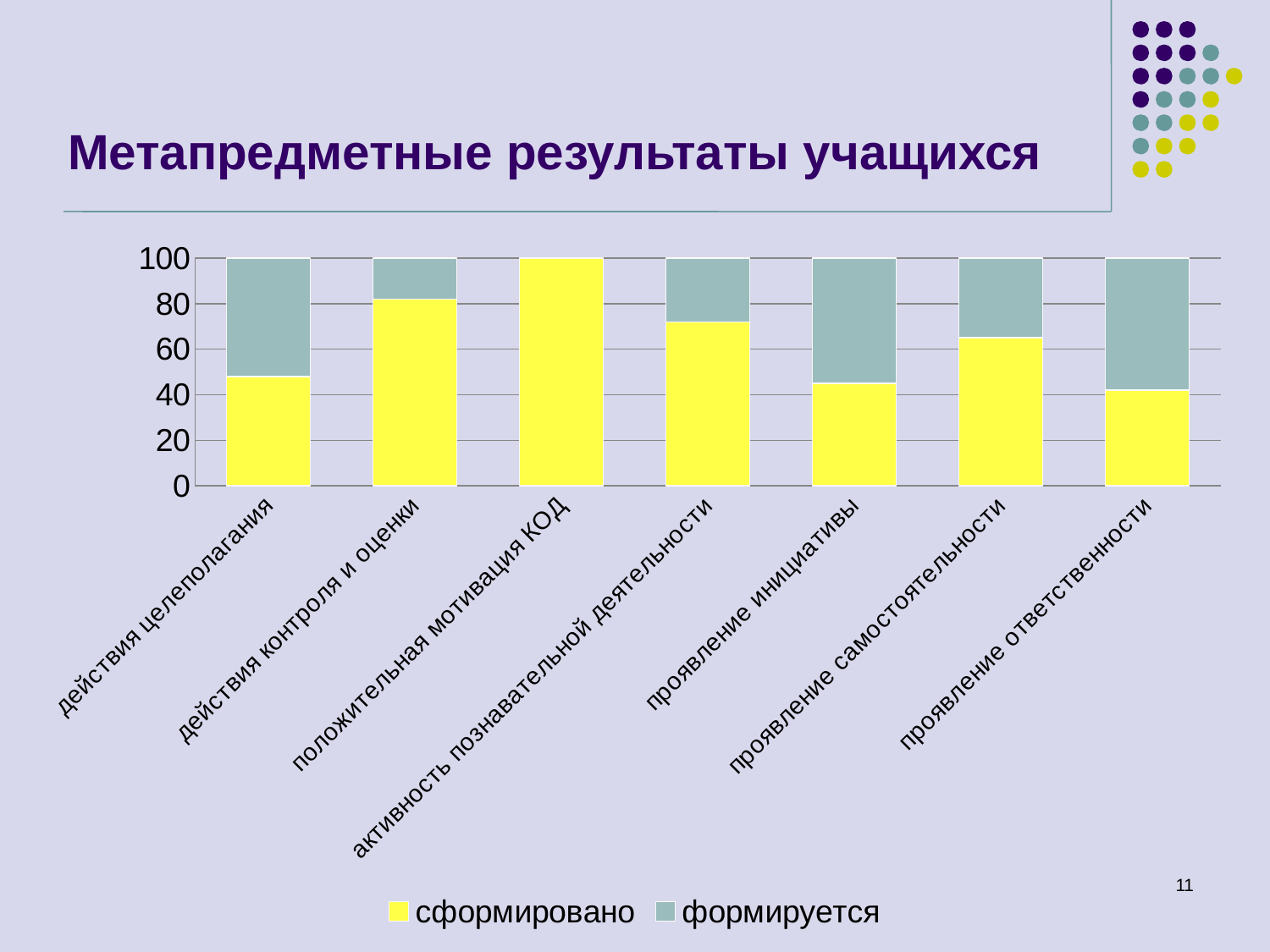
What is the total height of the stacked bar for 'действия целеполагания'? 100 Is the 'сформировано' value for 'действия целеполагания' greater or less than 60? less How many series does the chart legend list? 2 Which has the larger 'сформировано' value: 'действия контроля и оценки' or 'действия целеполагания'? действия контроля и оценки Is the 'сформировано' value for 'активность познавательной деятельности' greater or less than 60? greater Which category has the highest value for the series 'сформировано'? положительная мотивация КОД Is the 'сформировано' value for 'проявление инициативы' greater or less than 60? less What kind of chart is shown on the slide? stacked bar chart How many categories are shown on the x axis of the chart? 7 Which colour represents the series 'формируется' in the chart? grey-green